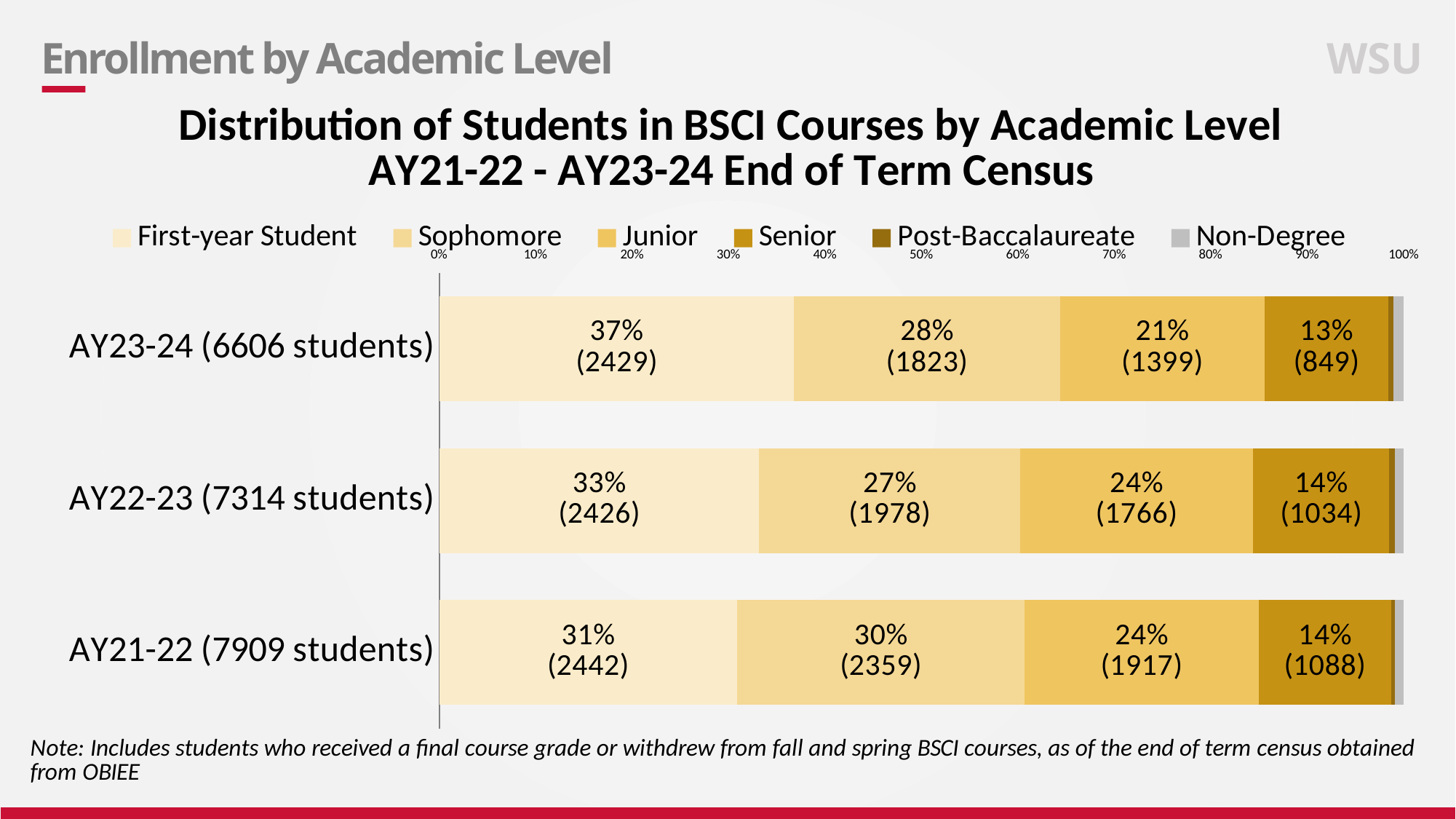
Which academic year has the lowest Senior percentage? AY23-24 How many Senior students were enrolled in BSCI courses in AY21-22? 1088 Which year has a larger Sophomore percentage, AY21-22 or AY22-23? AY21-22 Which academic year has the highest First-year Student percentage? AY23-24 What percentage of students in AY23-24 were First-year Students? 37% How many academic years are shown as bars in the chart? 3 Does the First-year Student percentage rise or fall from AY21-22 to AY23-24? Rise What is the difference in the number of Junior students between AY21-22 and AY23-24? 518 How many Sophomore students were in BSCI courses in AY22-23? 1978 How many academic levels does the legend list? 6 What type of chart is used to show the distribution of students by academic level? Stacked bar chart What is the difference in the number of Senior students between AY22-23 and AY23-24? 185